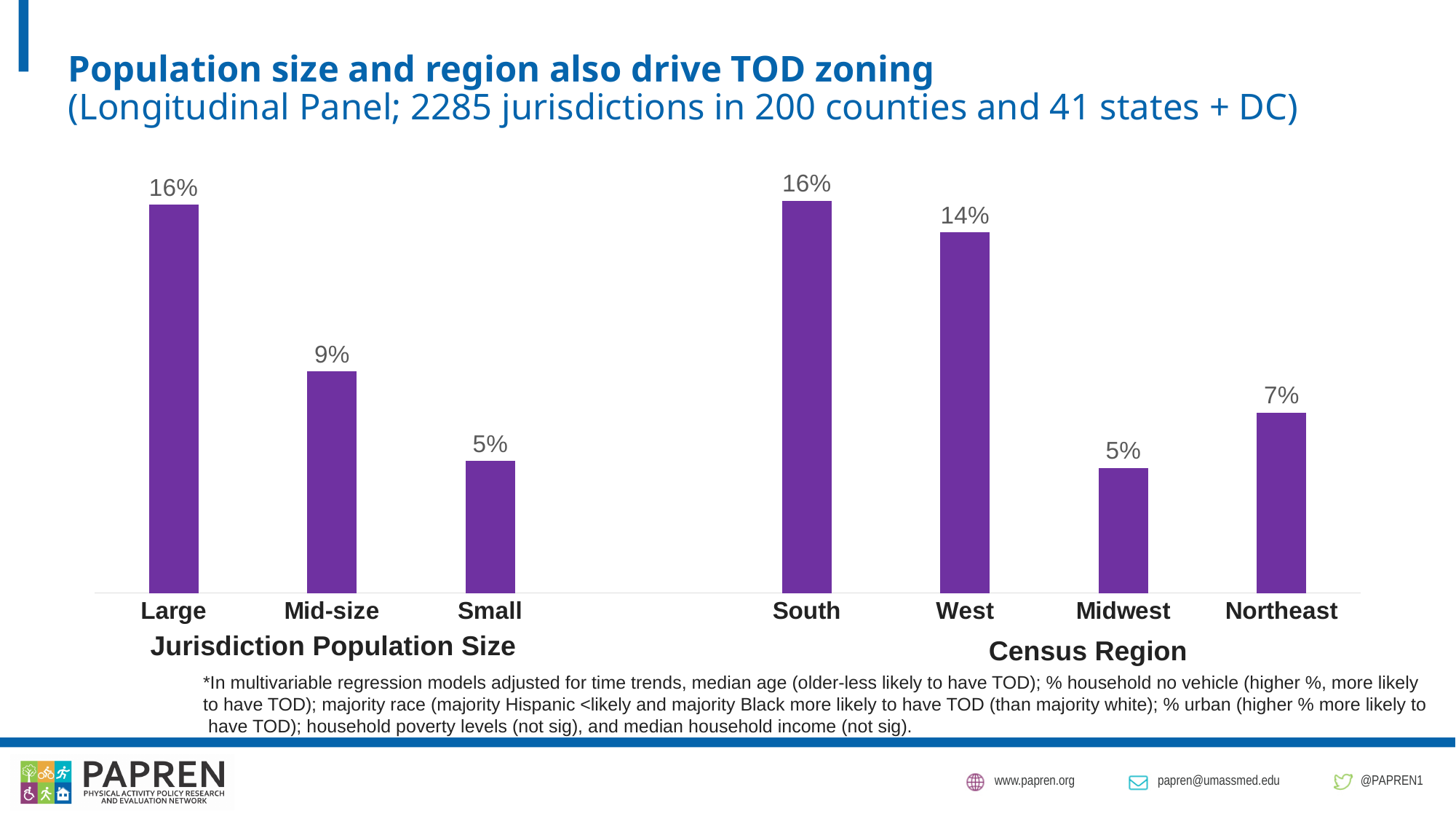
How many categories are shown in the Census Region chart? 4 In the Census Region chart, what is the difference between the values for South and West? 2% In the Census Region chart, what is the value for West? 14% In the Census Region chart, which region has the lowest value? Midwest In the Jurisdiction Population Size chart, which category has the lowest value? Small In the Jurisdiction Population Size chart, what is the difference between the values for Large and Small? 11% In the Jurisdiction Population Size chart, what is the value for Large? 16% What kind of chart is the Jurisdiction Population Size chart? Bar chart In the Jurisdiction Population Size chart, what is the value for Mid-size? 9% In the Census Region chart, what is the value for Northeast? 7% In the Census Region chart, which region has the highest value? South In the Census Region chart, which is larger, the value for Northeast or the value for Midwest? Northeast